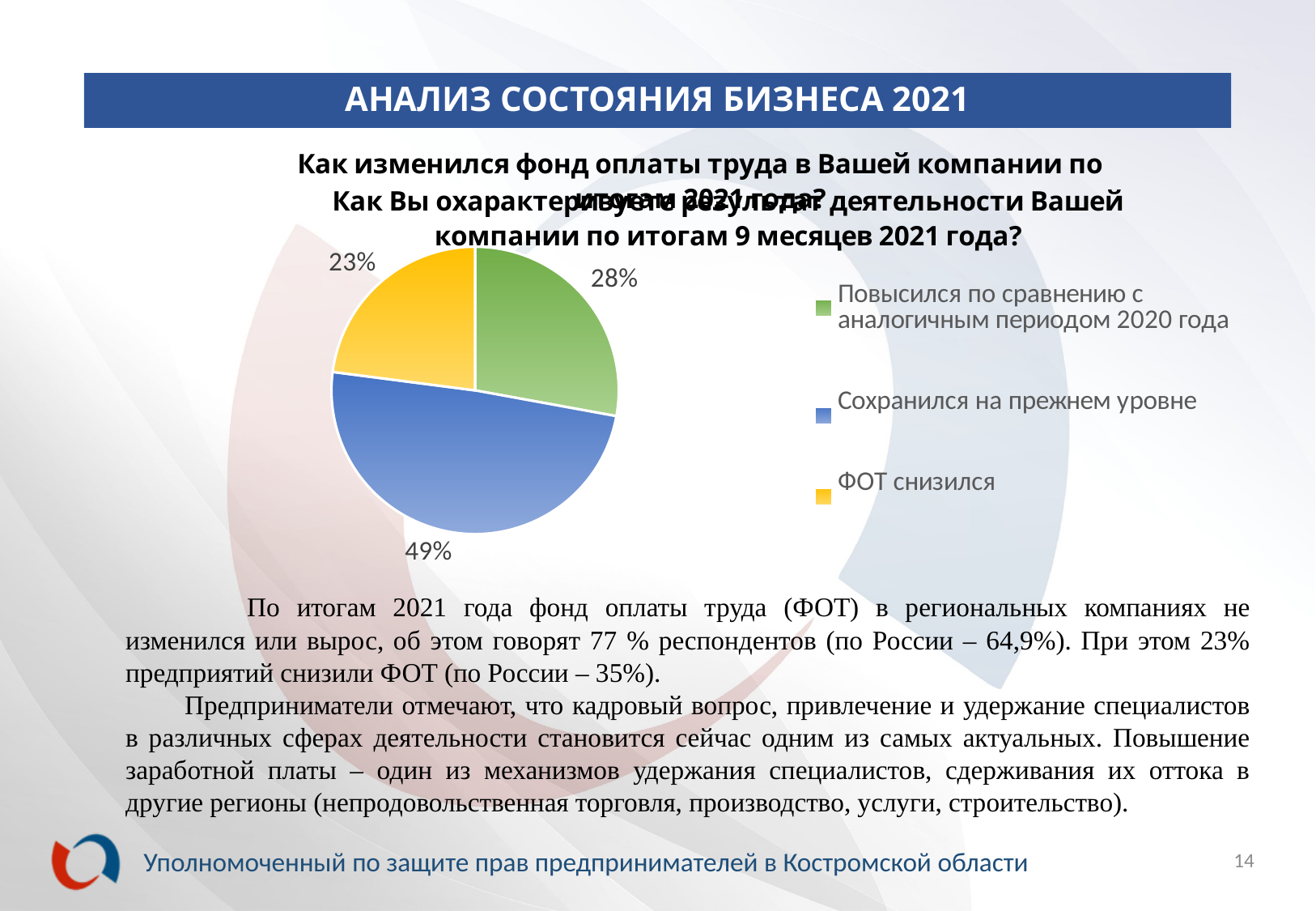
What colour is the slice for 'Сохранился на прежнем уровне'? Blue Which category has the largest slice of the pie chart? Сохранился на прежнем уровне What is the difference in percentage points between the 'Сохранился на прежнем уровне' slice and the 'ФОТ снизился' slice? 26 Which category has the smallest slice of the pie chart? ФОТ снизился What is the difference in percentage points between the 'Повысился по сравнению с аналогичным периодом 2020 года' slice and the 'ФОТ снизился' slice? 5 What colour is the slice for 'ФОТ снизился'? Yellow What type of chart is shown on the slide? Pie chart How many categories does the pie chart show? 3 What share of respondents said the payroll fund decreased (ФОТ снизился)? 23% What share of respondents said the payroll fund remained at the same level (Сохранился на прежнем уровне)? 49% Which is larger: the share for 'Повысился по сравнению с аналогичным периодом 2020 года' or the share for 'ФОТ снизился'? Повысился по сравнению с аналогичным периодом 2020 года What share of respondents said the payroll fund increased compared to the same period of 2020 (Повысился по сравнению с аналогичным периодом 2020 года)? 28%